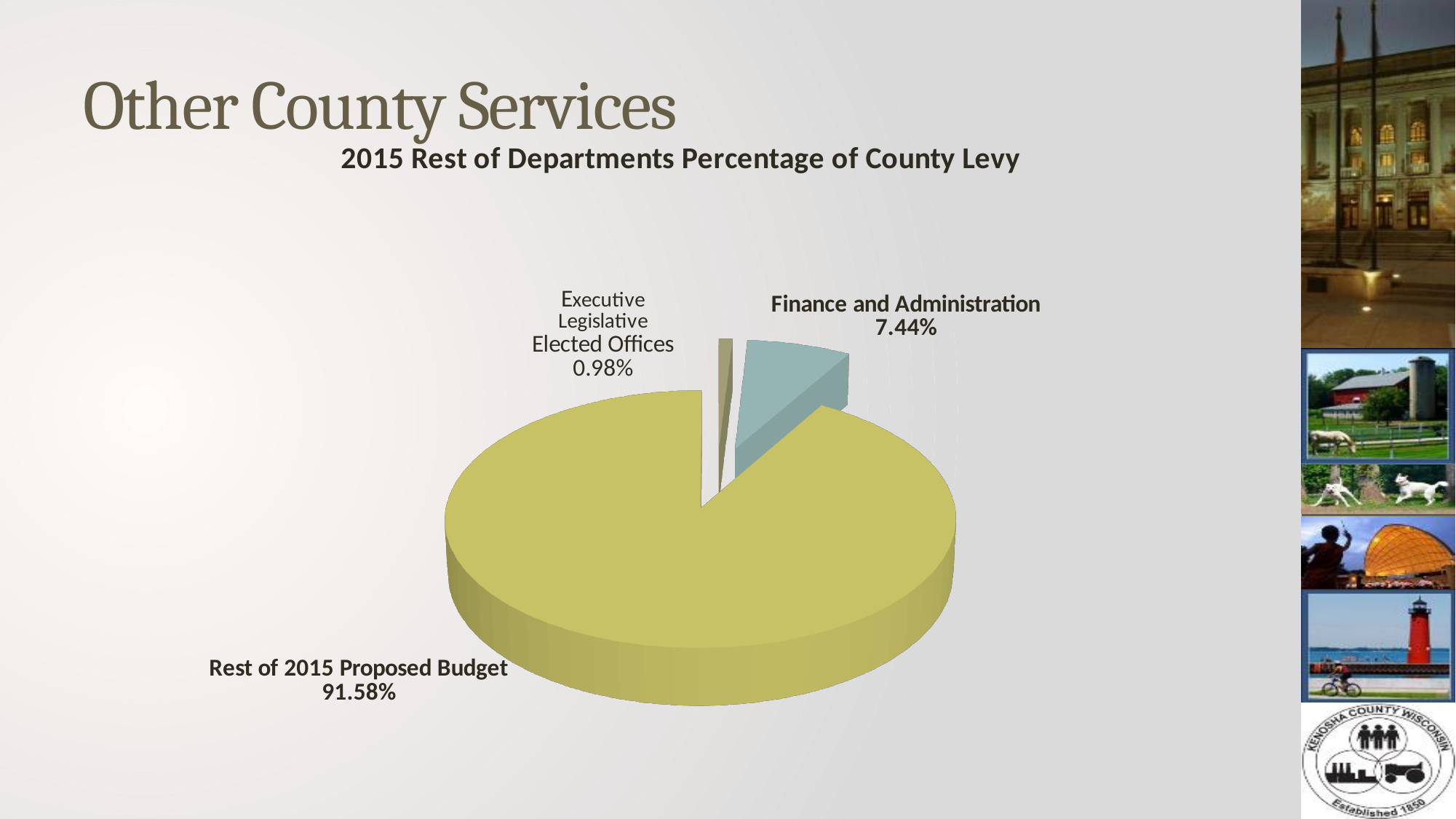
How many slices does the pie chart have? 3 What type of chart is shown on the slide? Pie chart Which slice of the pie chart is the smallest? Executive Legislative Elected Offices What percentage is shown for Rest of 2015 Proposed Budget? 91.58% What is the title of the chart? 2015 Rest of Departments Percentage of County Levy What is the difference in percentage points between Finance and Administration and Executive Legislative Elected Offices? 6.46 What percentage is shown for Executive Legislative Elected Offices? 0.98% Which is larger, Finance and Administration or Executive Legislative Elected Offices? Finance and Administration What colour is the Finance and Administration slice? Blue-grey What percentage of the county levy does Finance and Administration account for? 7.44% What is the combined percentage of Finance and Administration and Executive Legislative Elected Offices? 8.42% Which slice of the pie chart is the largest? Rest of 2015 Proposed Budget